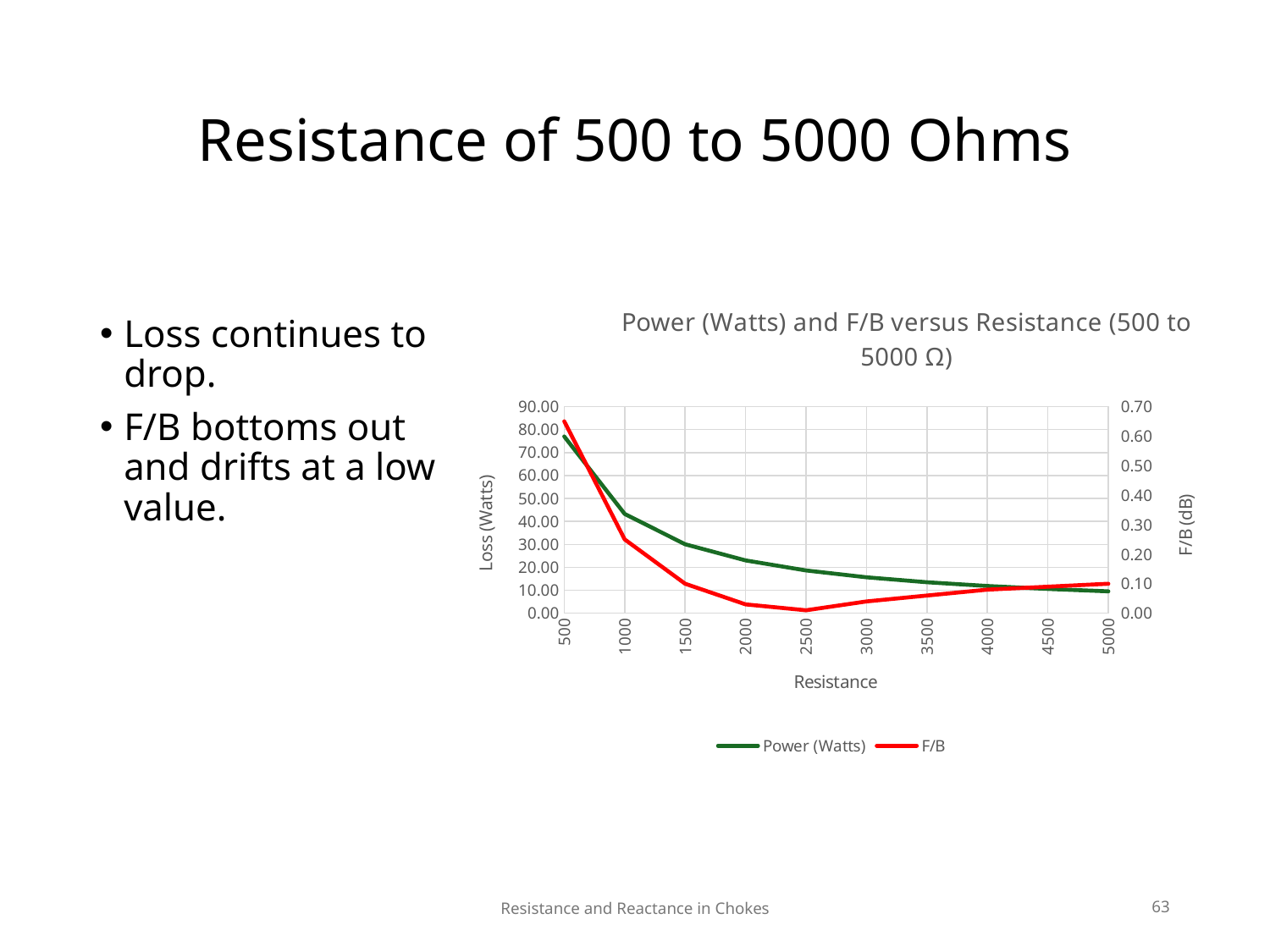
How many resistance values are plotted along the x axis? 10 Is the Power (Watts) value at a resistance of 500 greater or less than 70.00? greater Does the Power (Watts) series rise or fall as resistance increases from 500 to 5000? fall How many series does the legend list? 2 Which is larger, the Power (Watts) value at 1000 or at 1500? 1000 At which resistance is the Power (Watts) series lowest? 5000 What kind of chart is shown on the slide? line chart At which resistance is the Power (Watts) series highest? 500 At which resistance is the F/B series lowest? 2500 Is the Power (Watts) value at a resistance of 1000 greater or less than 50.00? less Is the F/B value at a resistance of 1500 greater or less than 0.20? less What is the title of the right-hand vertical axis? F/B (dB)